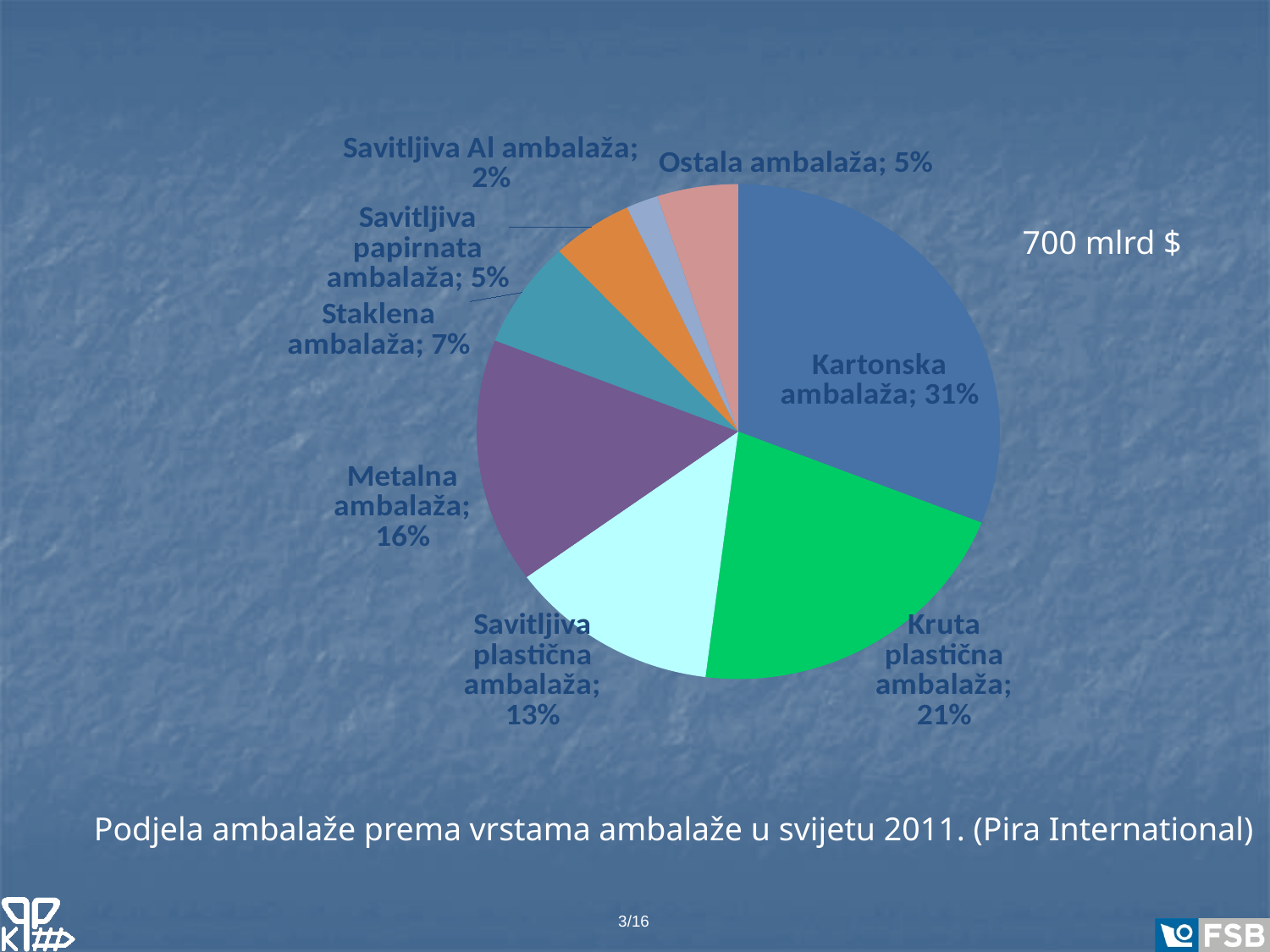
What is the value shown for Staklena ambalaža? 7% Which category has the smallest slice of the pie? Savitljiva Al ambalaža What kind of chart is shown on the slide? Pie chart What is the combined share of Kartonska ambalaža and Kruta plastična ambalaža? 52% Which is larger, Metalna ambalaža or Staklena ambalaža? Metalna ambalaža What is the difference between the shares of Kruta plastična ambalaža and Savitljiva plastična ambalaža? 8% Which category has the largest slice of the pie? Kartonska ambalaža What is the value shown for Metalna ambalaža? 16% What share of the pie does Kartonska ambalaža have? 31% What is the value shown for Savitljiva plastična ambalaža? 13% What total market value is written next to the pie chart? 700 mlrd $ How many categories are shown in the pie chart? 8